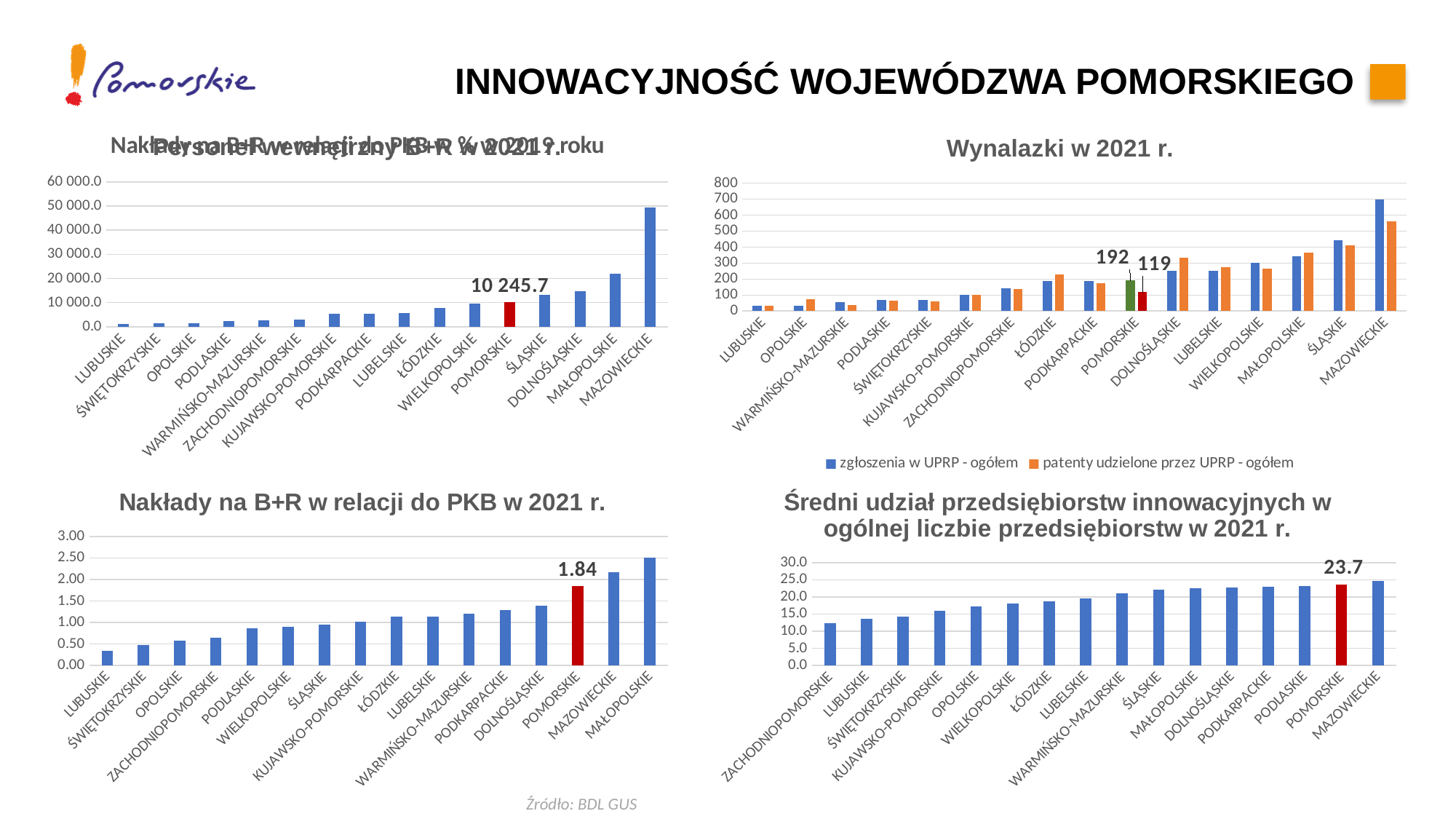
In the top-left chart, what is the value for POMORSKIE? 10 245.7 In the chart 'Nakłady na B+R w relacji do PKB w 2021 r.', is the value for MAZOWIECKIE greater or less than 2.00? greater In the chart 'Nakłady na B+R w relacji do PKB w 2021 r.', what is the value for POMORSKIE? 1.84 In the top-left chart, how many voivodeships are shown on the x axis? 16 In the chart 'Wynalazki w 2021 r.', which voivodeship has the highest number of 'zgłoszenia w UPRP - ogółem'? MAZOWIECKIE In the top-left chart, which voivodeship has the highest value? MAZOWIECKIE In the chart 'Wynalazki w 2021 r.', how many series does the legend list? 2 In the chart 'Wynalazki w 2021 r.', what is the value of 'patenty udzielone przez UPRP - ogółem' for POMORSKIE? 119 In the chart 'Wynalazki w 2021 r.', what is the value of 'zgłoszenia w UPRP - ogółem' for POMORSKIE? 192 In the chart 'Wynalazki w 2021 r.', what is the difference between the two values shown for POMORSKIE? 73 In the top-left chart, which voivodeship has the lowest value? LUBUSKIE In the chart 'Średni udział przedsiębiorstw innowacyjnych w ogólnej liczbie przedsiębiorstw w 2021 r.', what is the value for POMORSKIE? 23.7